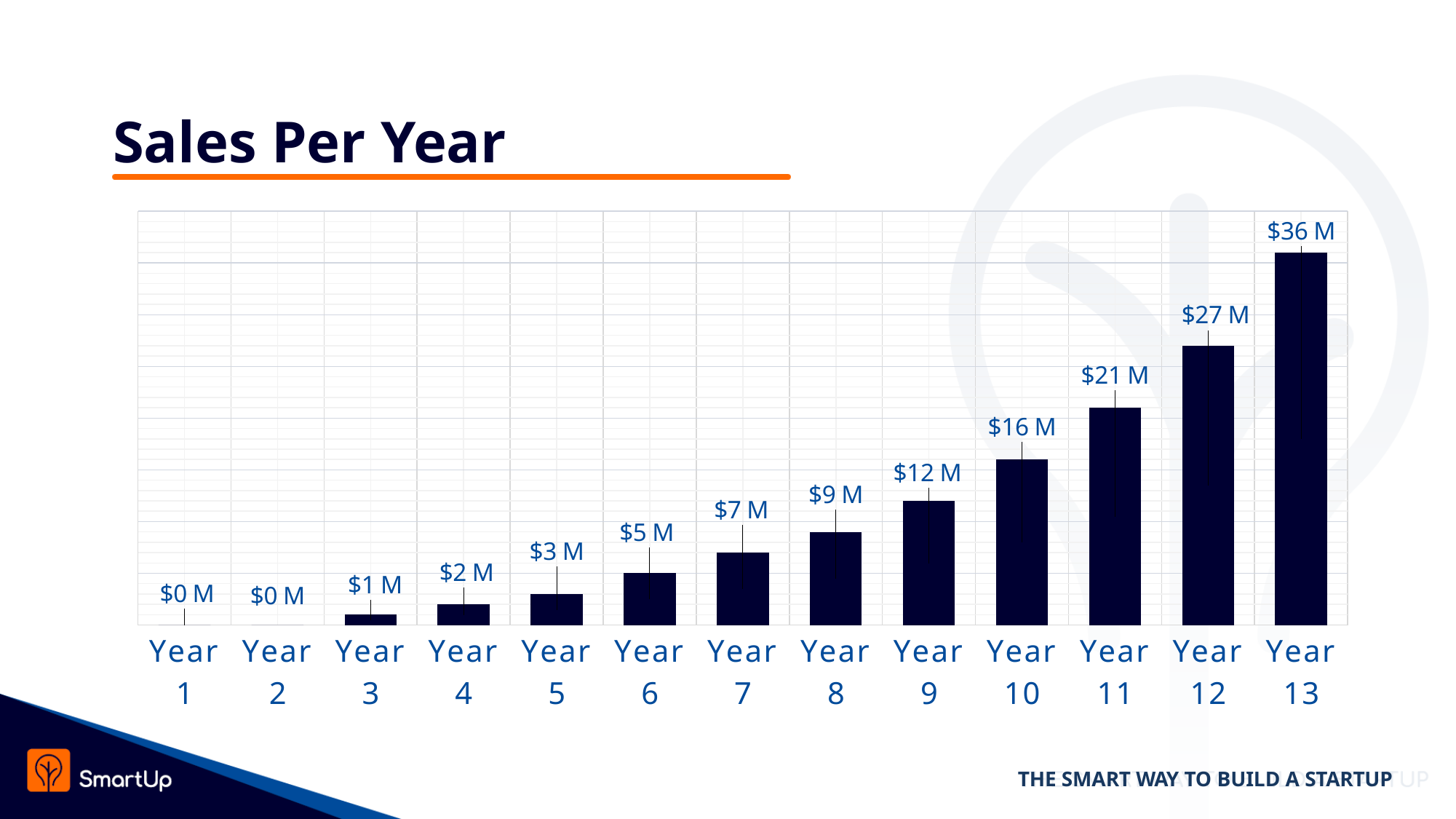
What is the difference between the values for Year 12 and Year 10? $11 M What is the title of the chart? Sales Per Year Which is larger, the value for Year 6 or the value for Year 9? Year 9 What kind of chart is shown on the slide? Bar chart How many years are shown on the x axis? 13 What is the difference between the values for Year 13 and Year 9? $24 M What is the value for Year 13? $36 M Do the values rise or fall from Year 1 to Year 13? Rise What is the value for Year 5? $3 M What is the value for Year 11? $21 M Which year has the highest sales? Year 13 What is the value for Year 8? $9 M